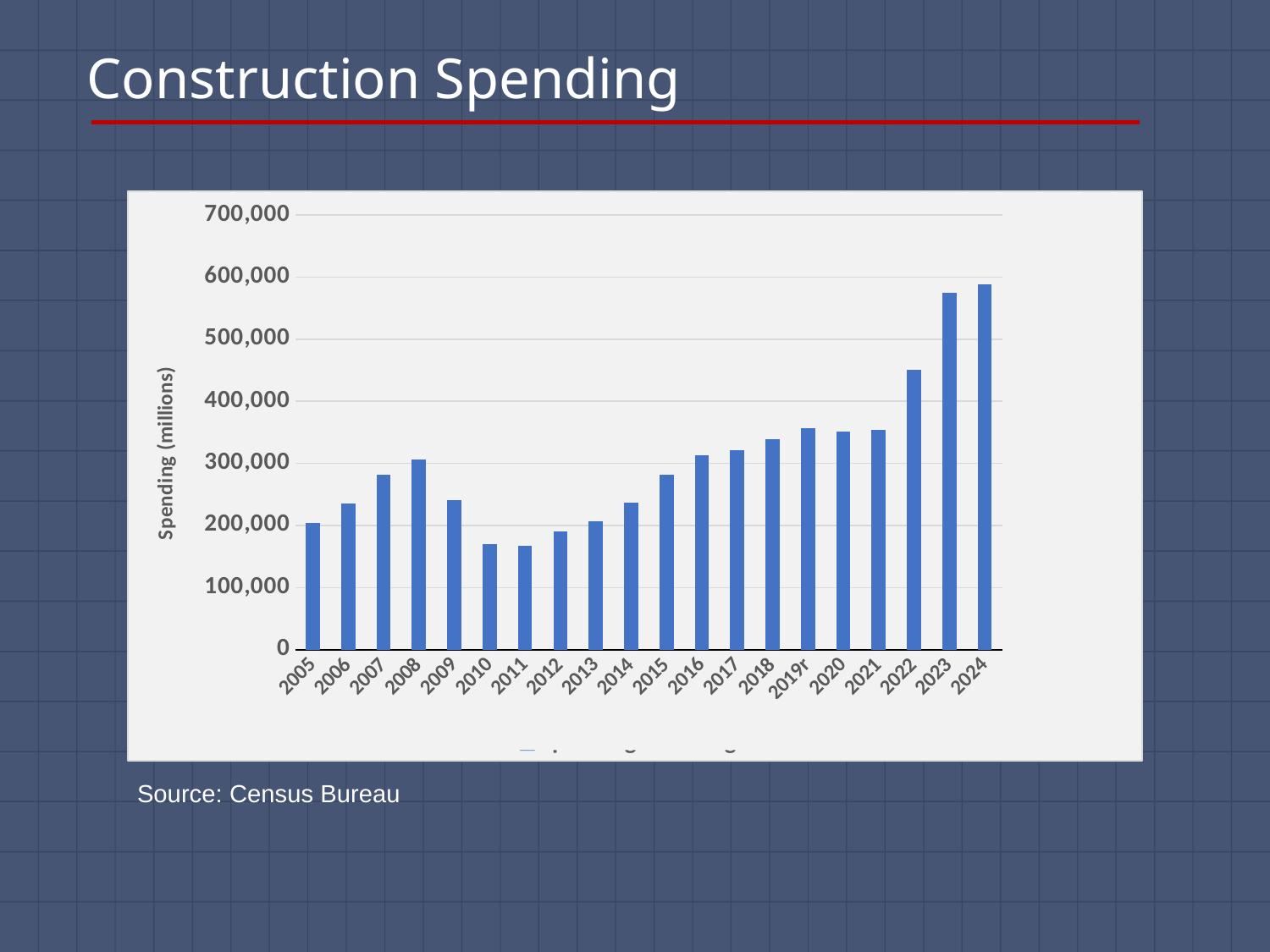
Do the values rise or fall from 2012 to 2024? rise Is the value for 2009 greater or less than 300,000? less What is the label on the vertical axis of the chart? Spending (millions) Is the value for 2010 greater or less than 200,000? less Is the value for 2022 greater or less than 400,000? greater Which year has the highest construction spending in the chart? 2024 Which year has the larger value, 2022 or 2023? 2023 How many years are plotted on the x axis of the chart? 20 Which year has the larger value, 2008 or 2009? 2008 What kind of chart is shown on the slide? bar chart